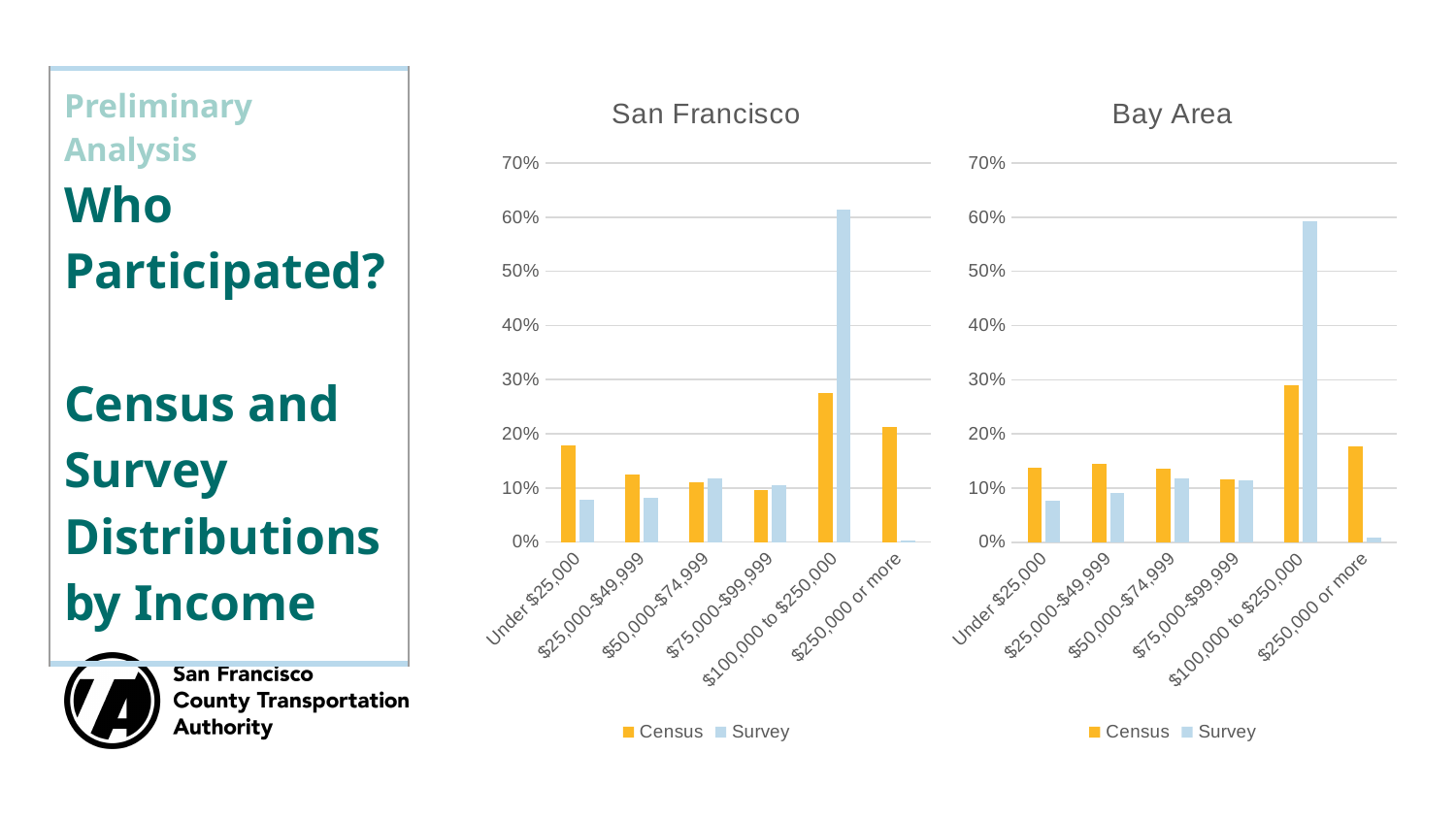
In the San Francisco chart, is the Survey value for $100,000 to $250,000 greater or less than 50%? greater In the San Francisco chart, which income category has the lowest Survey value? $250,000 or more In the San Francisco chart, for Under $25,000, which is larger: Census or Survey? Census In the Bay Area chart, is the Survey value for $100,000 to $250,000 greater or less than 50%? greater How many series does the legend of the San Francisco chart list? 2 In the Bay Area chart, which income category has the highest Census value? $100,000 to $250,000 What colour represents the Census series in the charts? yellow In the Bay Area chart, for $250,000 or more, which is larger: Census or Survey? Census What kind of chart is the San Francisco chart? bar chart In the Bay Area chart, is the Census value for $250,000 or more greater or less than 20%? less In the San Francisco chart, which income category has the highest Survey value? $100,000 to $250,000 How many income categories are shown on the x axis of the Bay Area chart? 6